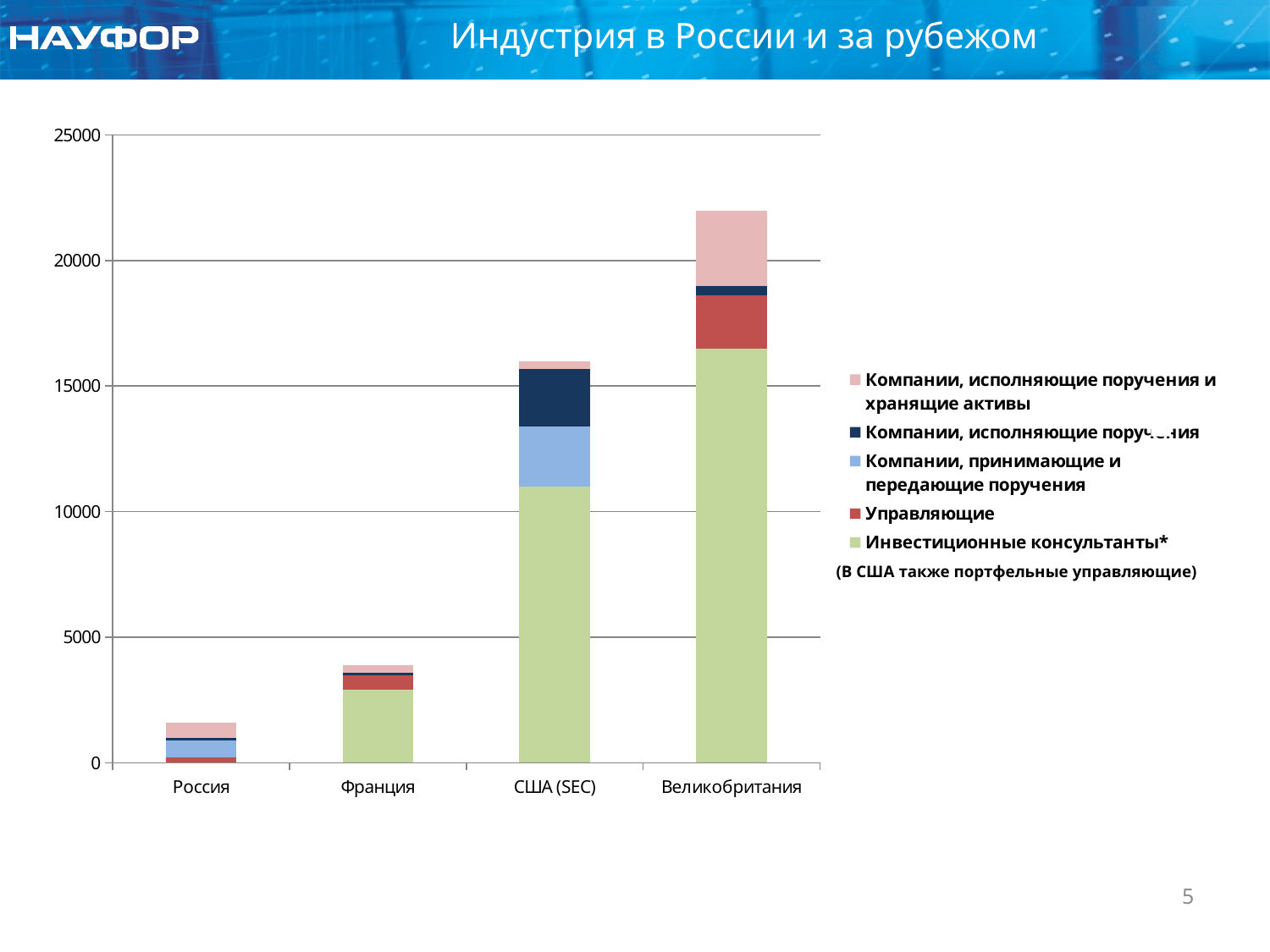
Which category has the lowest total bar? Россия Which category has the highest total bar? Великобритания How many categories are shown on the x axis of the chart? 4 Is the total value for США (SEC) greater or less than 15000? greater What kind of chart is shown on the slide? stacked bar chart Is the total value for Великобритания greater or less than 20000? greater Which legend entry is shown in green? Инвестиционные консультанты* Do the total bar values rise or fall from left to right along the x axis? rise How many series does the chart legend list? 5 Which has the larger total bar, Россия or Франция? Франция Is the value of the Инвестиционные консультанты* segment for США (SEC) greater or less than 10000? greater